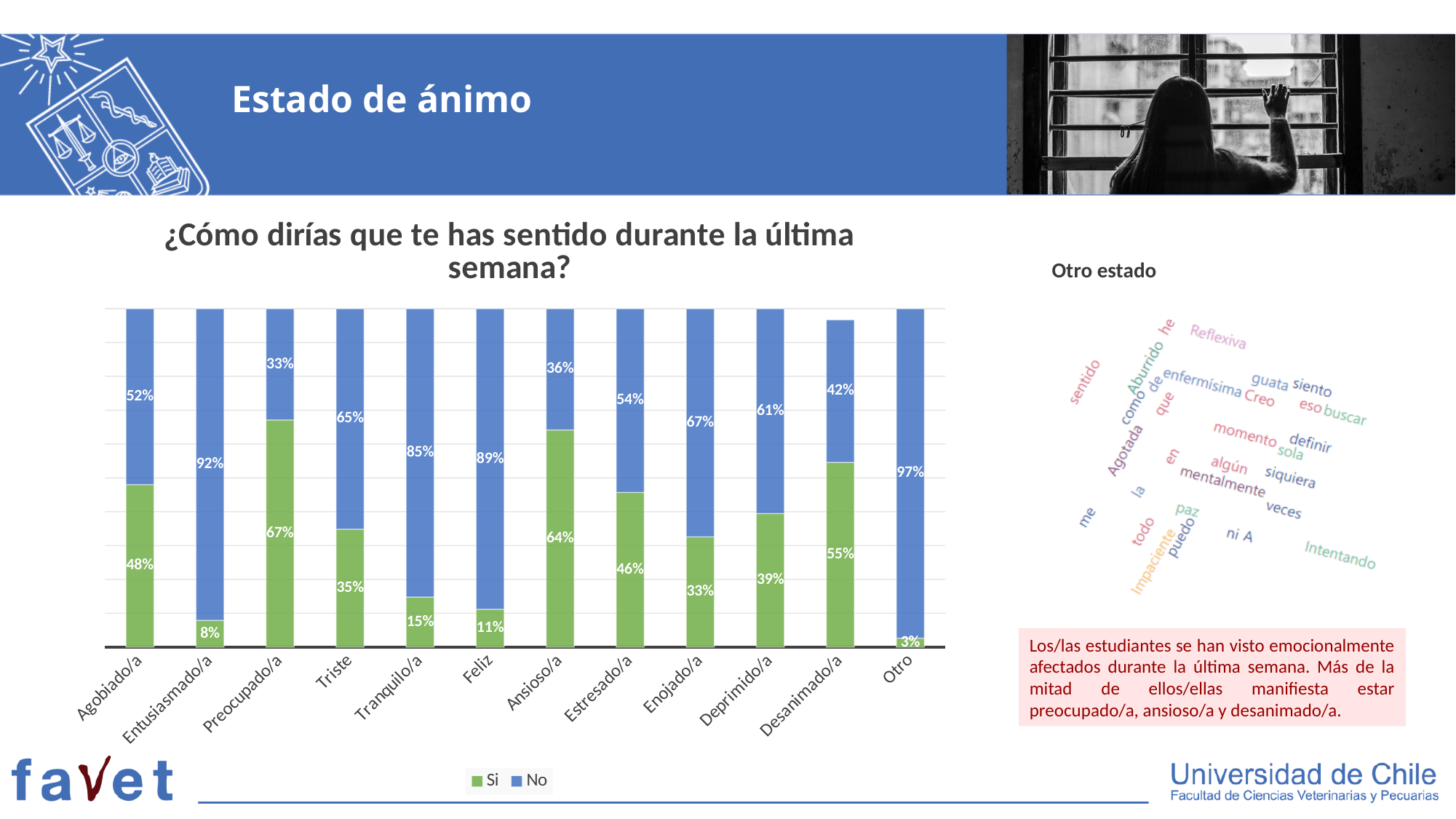
What is the total of the "Si" and "No" values for Desanimado/a? 97% Which category has the highest "Si" percentage? Preocupado/a What is the "Si" value for Tranquilo/a? 15% What percentage of students answered "Si" for Preocupado/a? 67% How many categories are shown on the x axis of the chart? 12 What kind of chart is shown on the slide? Stacked bar chart How many series does the legend list? 2 What is the difference between the "Si" values for Ansioso/a and Estresado/a? 18% Which has a larger "Si" value, Triste or Deprimido/a? Deprimido/a Which colour represents the "No" series in the chart? Blue Which category has the lowest "Si" percentage? Otro What is the "No" value for Entusiasmado/a? 92%